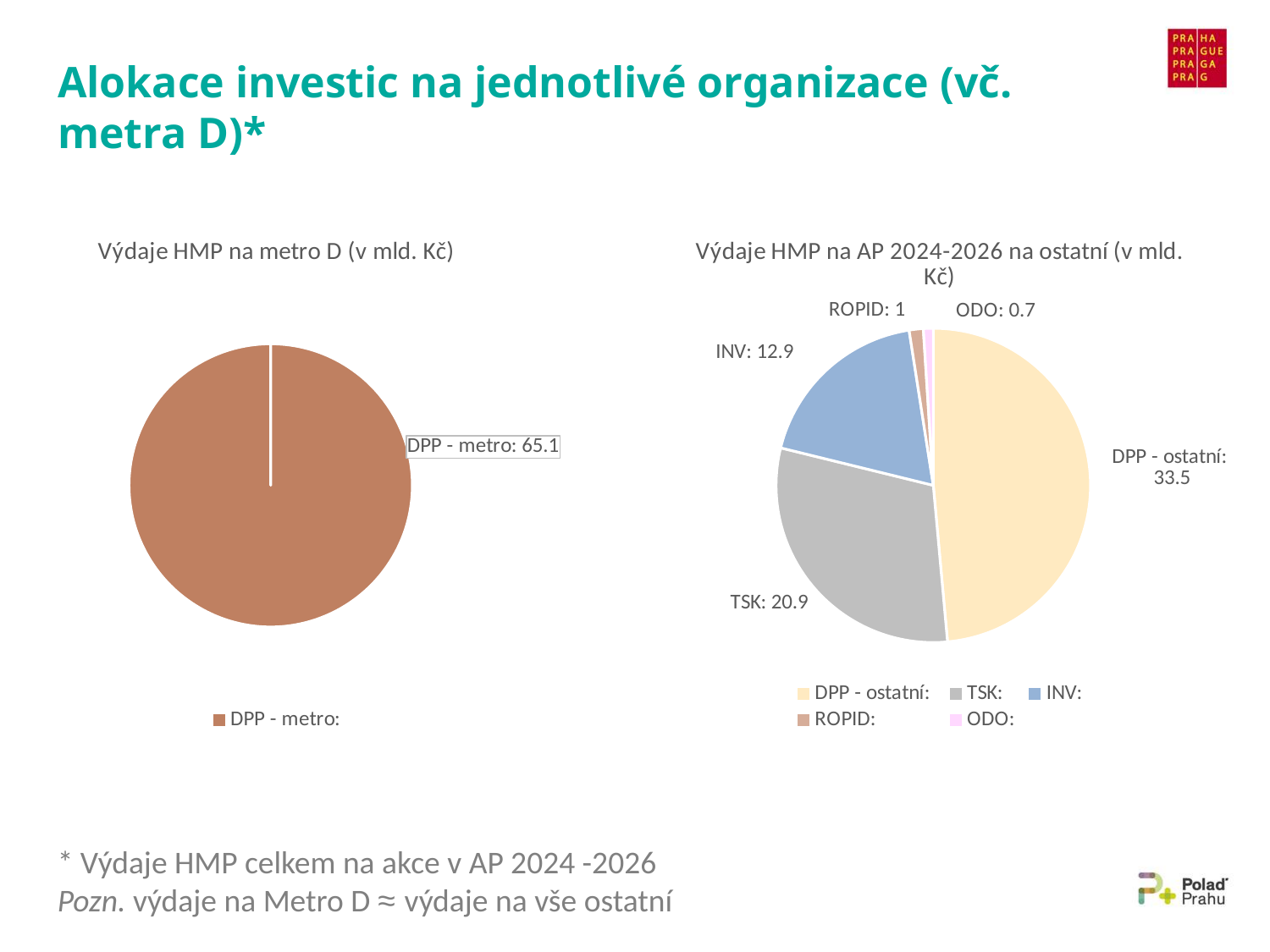
In the right chart (Výdaje HMP na AP 2024-2026 na ostatní), what is the value for TSK? 20.9 In the right chart (Výdaje HMP na AP 2024-2026 na ostatní), what is the value for INV? 12.9 In the right chart (Výdaje HMP na AP 2024-2026 na ostatní), what is the difference between DPP - ostatní and TSK? 12.6 In the right chart (Výdaje HMP na AP 2024-2026 na ostatní), which category has the smallest slice? ODO In the left chart (Výdaje HMP na metro D), what is the value for DPP - metro? 65.1 In the right chart (Výdaje HMP na AP 2024-2026 na ostatní), what is the difference between INV and ROPID? 11.9 What is the total of all slices in the right chart (Výdaje HMP na AP 2024-2026 na ostatní)? 69.0 How many categories does the right chart (Výdaje HMP na AP 2024-2026 na ostatní) show? 5 In the right chart (Výdaje HMP na AP 2024-2026 na ostatní), which is larger, TSK or INV? TSK In the right chart (Výdaje HMP na AP 2024-2026 na ostatní), which category has the largest slice? DPP - ostatní How many entries does the legend of the left chart (Výdaje HMP na metro D) list? 1 What kind of chart is the left chart (Výdaje HMP na metro D)? Pie chart